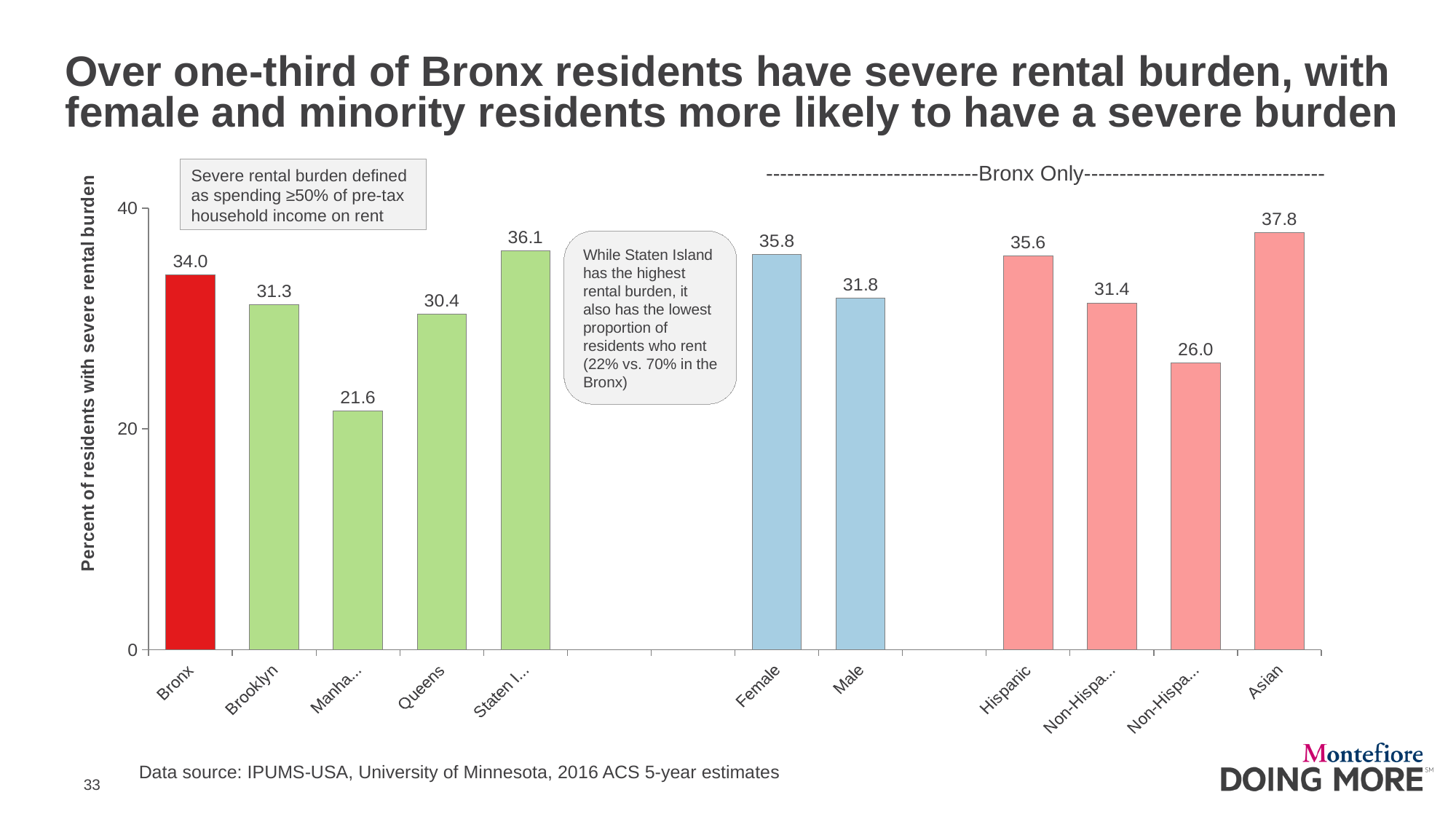
What is the value shown for Asian residents in the Bronx? 37.8 Which has a higher value, the Bronx or Brooklyn? Bronx What is the value shown for Male residents in the Bronx? 31.8 What is the value shown for Brooklyn? 31.3 What is the value shown for Queens? 30.4 What is the percent of residents with severe rental burden for the Bronx? 34.0 What is the value shown for Female residents in the Bronx? 35.8 Which category has the highest bar in the chart? Asian How many bars are plotted in the chart? 11 What is the difference between the Female and Male values? 4.0 What kind of chart is shown on the slide? Bar chart What is the label on the vertical axis of the chart? Percent of residents with severe rental burden